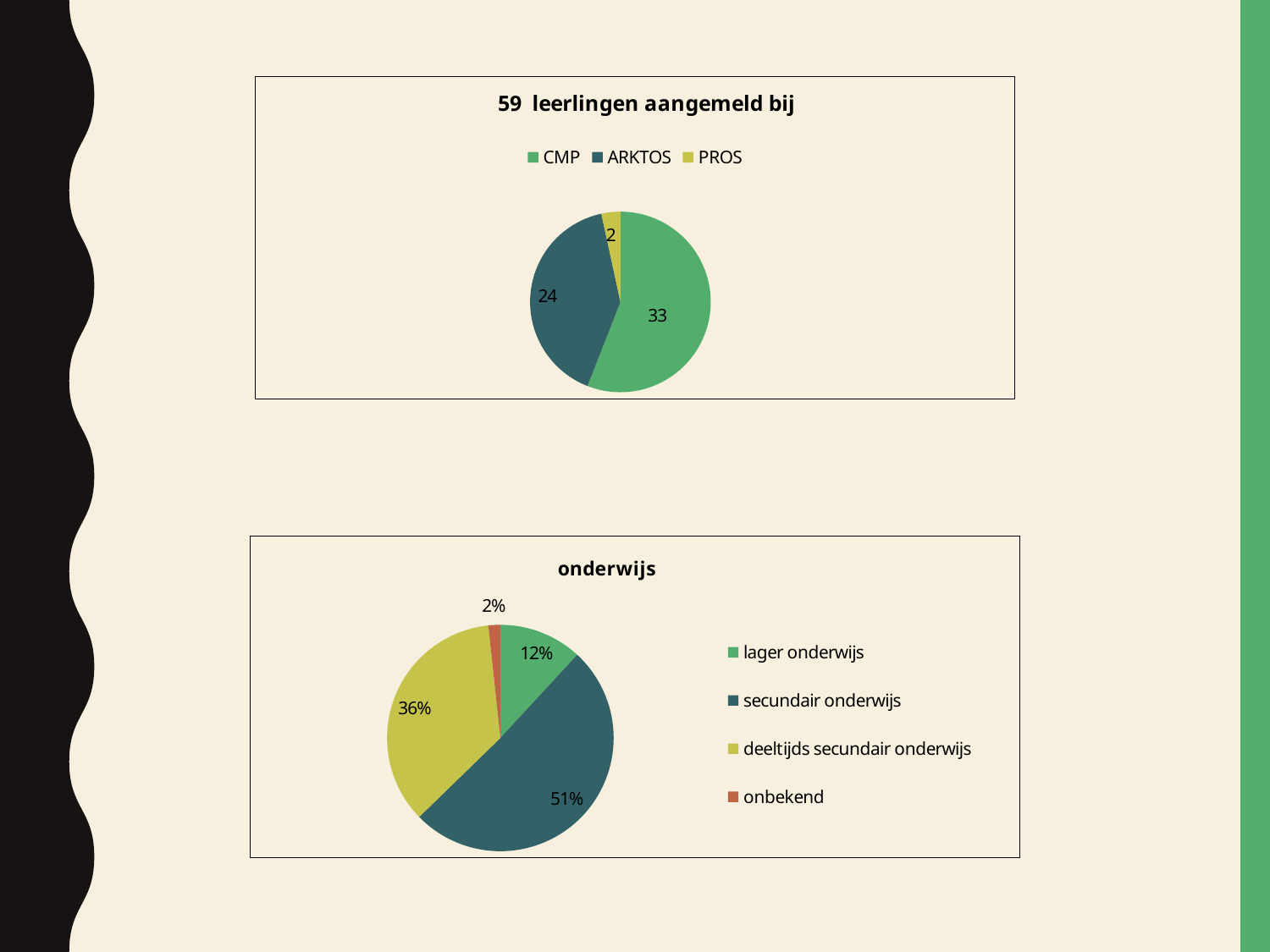
In the chart titled "onderwijs", what share is secundair onderwijs? 51% In the chart titled "59 leerlingen aangemeld bij", how many leerlingen are registered with CMP? 33 What kind of chart is the chart titled "59 leerlingen aangemeld bij"? pie chart In the chart titled "59 leerlingen aangemeld bij", how many categories does the legend list? 3 In the chart titled "onderwijs", which category has the largest share? secundair onderwijs In the chart titled "onderwijs", what share is deeltijds secundair onderwijs? 36% In the chart titled "59 leerlingen aangemeld bij", how many leerlingen are registered with ARKTOS? 24 In the chart titled "onderwijs", what is the difference between the shares of secundair onderwijs and deeltijds secundair onderwijs? 15% In the chart titled "onderwijs", how many categories does the legend list? 4 In the chart titled "onderwijs", which is larger: lager onderwijs or onbekend? lager onderwijs In the chart titled "59 leerlingen aangemeld bij", which organisation has the fewest leerlingen? PROS In the chart titled "59 leerlingen aangemeld bij", what is the difference between the CMP and ARKTOS values? 9